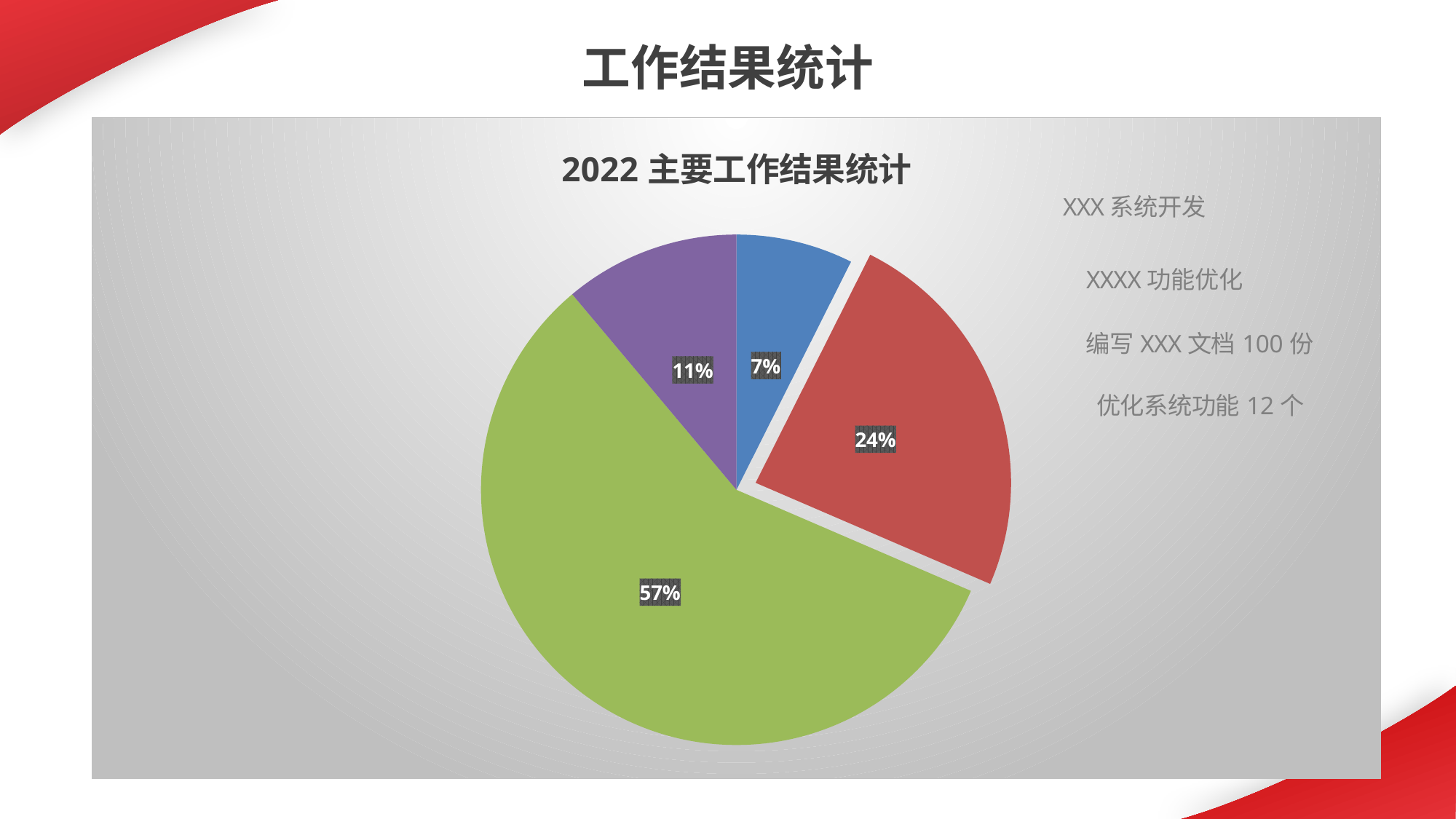
What percentage is shown on the green slice? 57% What percentage is shown on the blue slice? 7% What is the share of the smallest slice of the pie? 7% What is the title of the chart? 2022 主要工作结果统计 What kind of chart is shown on the slide? pie chart What percentage is shown on the red slice? 24% How many slices does the pie chart have? 4 Which slice is larger, the red slice or the purple slice? the red slice What is the difference in percentage points between the green slice (57%) and the red slice (24%)? 33 What percentage is shown on the purple slice? 11% What is the share of the largest slice of the pie? 57%